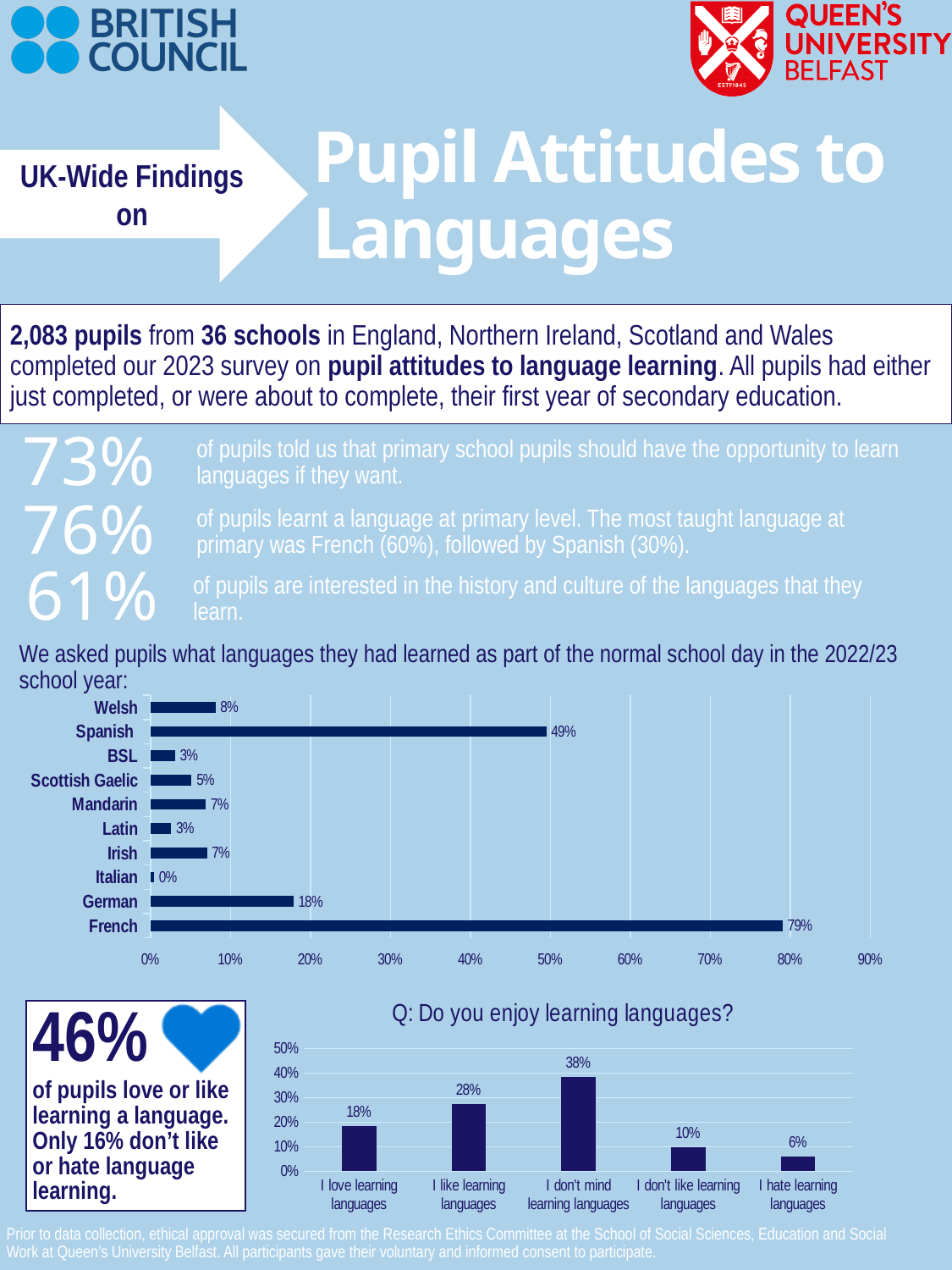
How many response categories are shown in the chart titled 'Q: Do you enjoy learning languages?'? 5 In the languages-learned bar chart (upper chart), which language has the lowest value? Italian In the languages-learned bar chart (upper chart), which has a larger value, Welsh or Mandarin? Welsh In the chart titled 'Q: Do you enjoy learning languages?', which response has the highest value? I don't mind learning languages In the languages-learned bar chart (upper chart), what percentage of pupils learned German? 18% What type of chart is the languages-learned chart (upper chart)? Bar chart In the chart titled 'Q: Do you enjoy learning languages?', what is the difference between 'I love learning languages' and 'I hate learning languages'? 12% In the languages-learned bar chart (upper chart), which language has the highest value? French In the languages-learned bar chart (upper chart), what is the difference between the values for French and Spanish? 30% How many languages are listed in the languages-learned bar chart (upper chart)? 10 In the chart titled 'Q: Do you enjoy learning languages?', what percentage of pupils said 'I like learning languages'? 28% In the languages-learned bar chart (upper chart), what percentage of pupils learned French? 79%